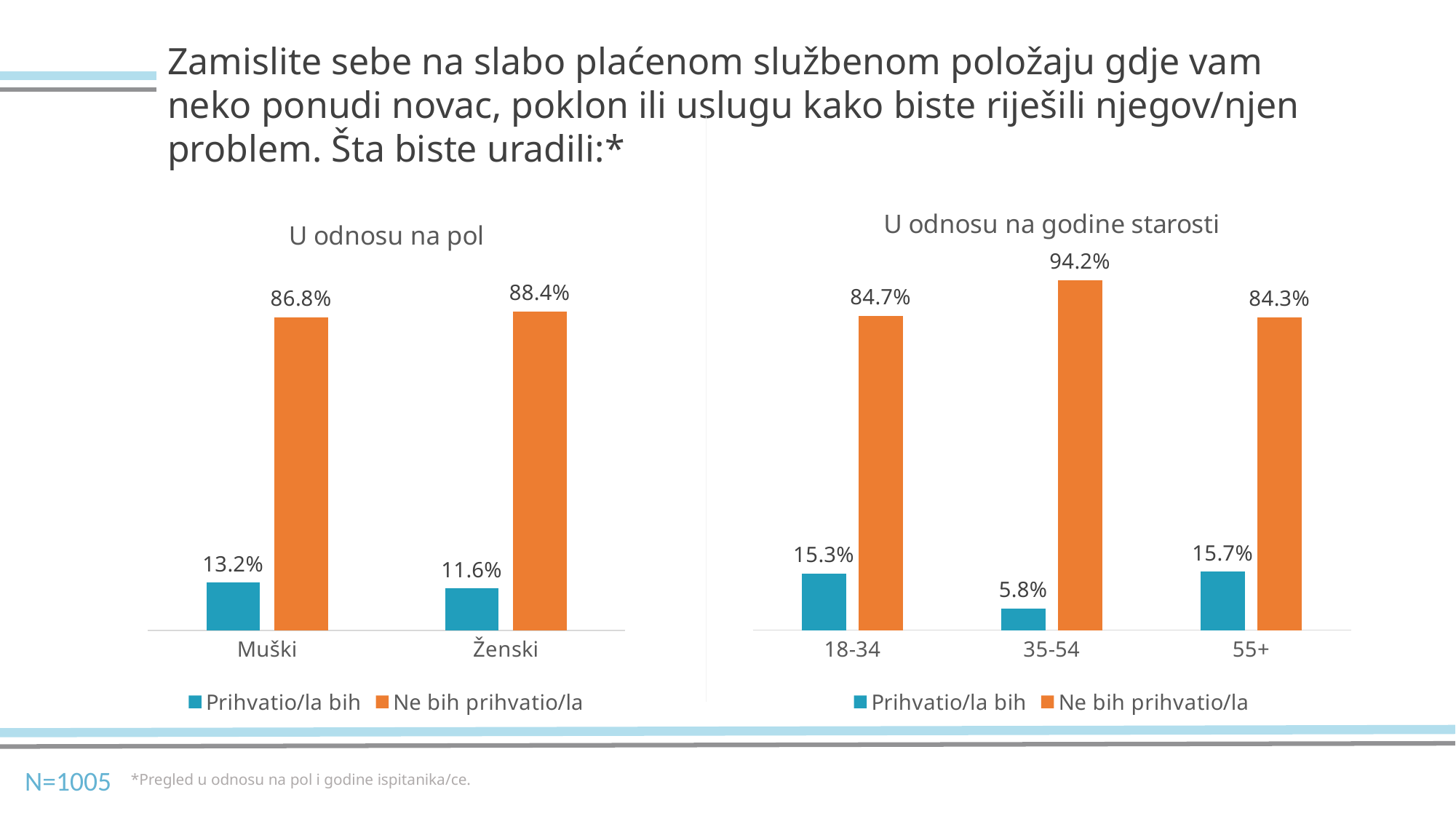
In the chart 'U odnosu na godine starosti', what is the value for 'Prihvatio/la bih' for the 55+ group? 15.7% What type of chart is 'U odnosu na godine starosti'? Bar chart In the chart 'U odnosu na godine starosti', what is the difference between the 'Ne bih prihvatio/la' values for 35-54 and 18-34? 9.5% In the chart 'U odnosu na godine starosti', what is the value for 'Ne bih prihvatio/la' for the 35-54 group? 94.2% In the chart 'U odnosu na pol', what is the value for 'Prihvatio/la bih' for Muški? 13.2% In the chart 'U odnosu na godine starosti', which age group has the lowest value for 'Prihvatio/la bih'? 35-54 In the chart 'U odnosu na godine starosti', which age group has the highest value for 'Ne bih prihvatio/la'? 35-54 In the chart 'U odnosu na pol', what is the difference between the 'Prihvatio/la bih' values for Muški and Ženski? 1.6% How many age groups are shown in the chart 'U odnosu na godine starosti'? 3 In the chart 'U odnosu na pol', which is larger: 'Ne bih prihvatio/la' for Muški or for Ženski? Ženski In the chart 'U odnosu na pol', what is the value for 'Ne bih prihvatio/la' for Ženski? 88.4% How many series does the legend of the chart 'U odnosu na pol' list? 2